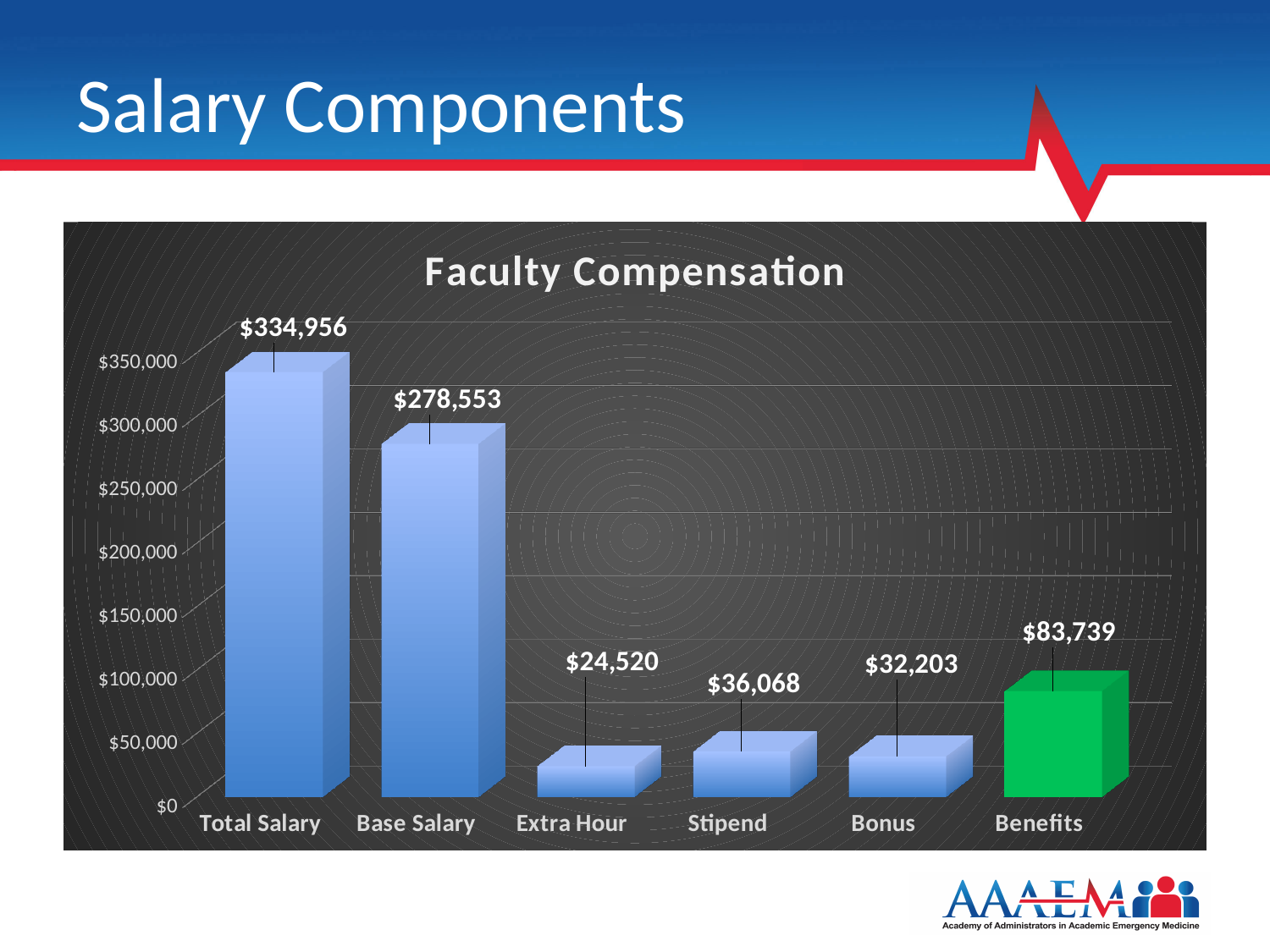
What is the value for Benefits? $83,739 What kind of chart is this? bar chart What is the value for Total Salary? $334,956 Which is larger, Stipend or Bonus? Stipend Is the value for Benefits greater or less than $100,000? less What is the title of the chart? Faculty Compensation Which category has the lowest value? Extra Hour What is the value for Extra Hour? $24,520 What is the difference between Total Salary and Base Salary? $56,403 How many categories are shown on the x axis? 6 What is the value for Base Salary? $278,553 Which category has the highest value? Total Salary